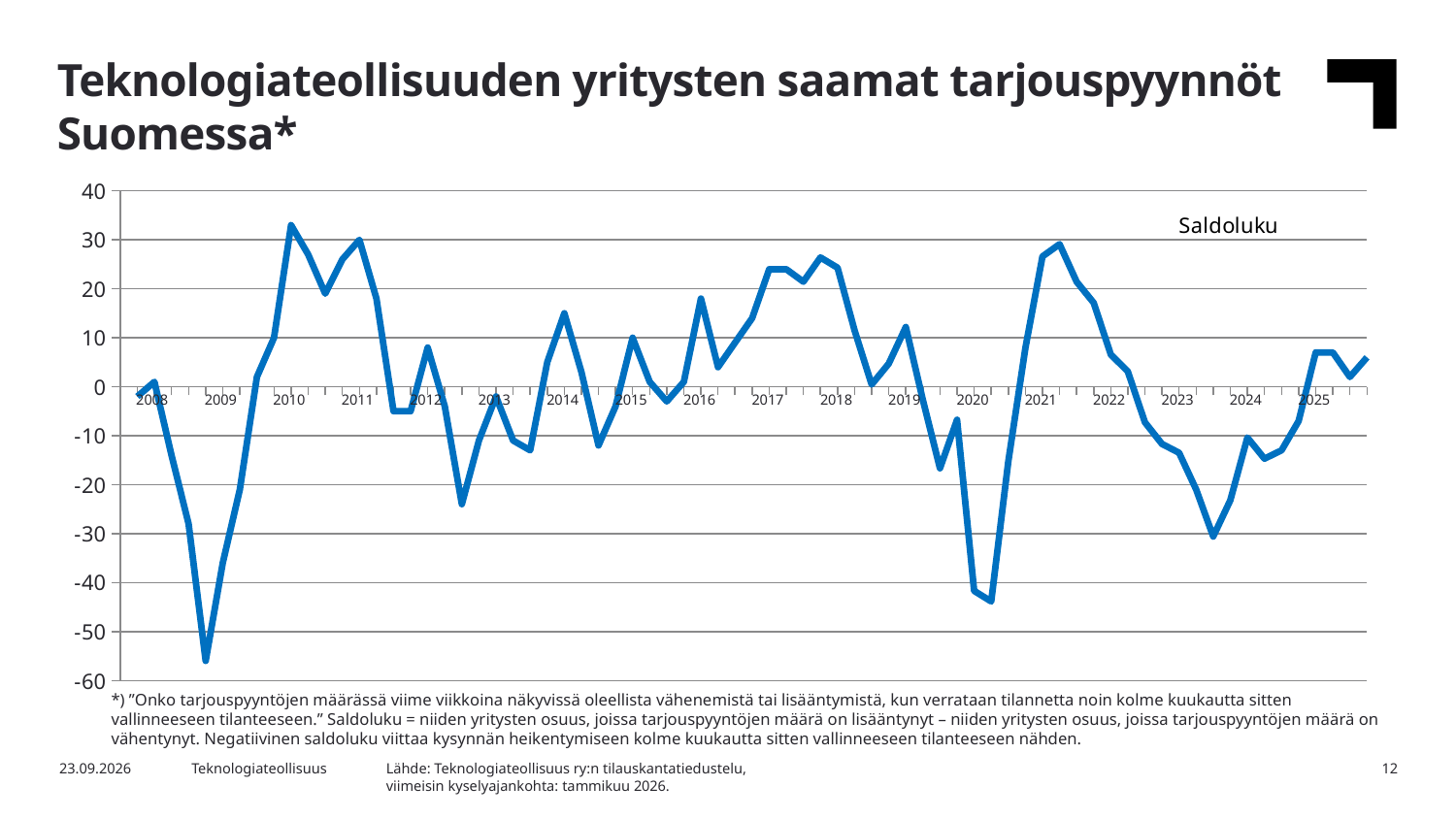
Is the lowest value of the line in 2020 greater or less than -40? less Does the line rise or fall between the start of 2020 and the start of 2021? rise Does the line rise or fall between the start of 2008 and the start of 2009? fall Is the lowest value of the line, reached in 2009, greater or less than -50? less What is the name of the series plotted in the chart? Saldoluku Is the peak value of the line in 2021 greater or less than 20? greater What is the title of the chart on the slide? Teknologiateollisuuden yritysten saamat tarjouspyynnöt Suomessa* What kind of chart is shown on the slide? line chart How many year labels are shown on the x axis of the chart? 18 In which year does the line reach its lowest point? 2009